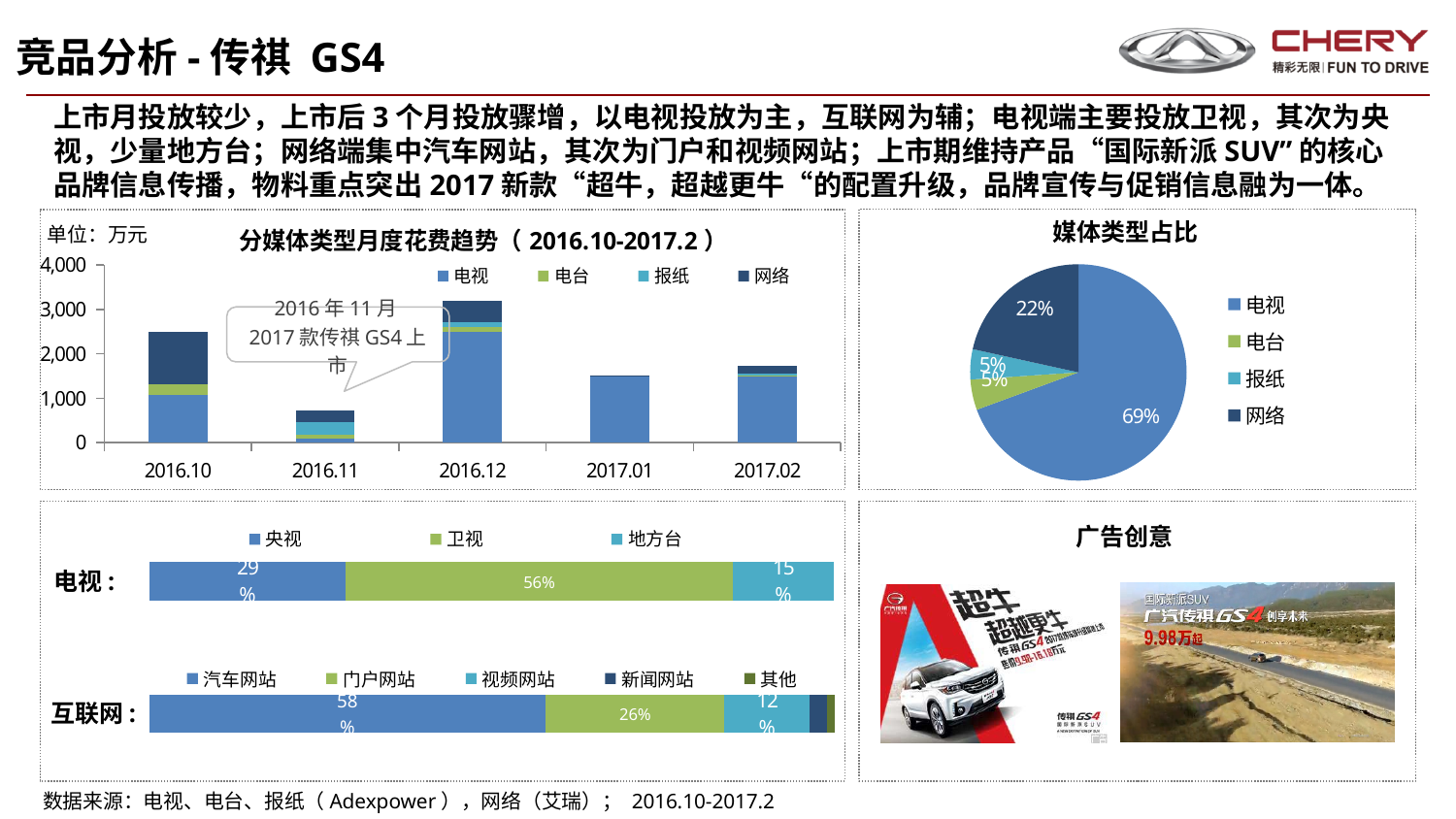
In the 互联网 stacked bar, how many series does the legend list? 5 In the 分媒体类型月度花费趋势 chart, is the total for 2016.11 greater or less than 1,000? less In the 媒体类型占比 pie chart, how many slices are there? 4 In the 电视 stacked bar, what is the value for 卫视? 56% In the 媒体类型占比 pie chart, which media type has the largest slice? 电视 In the 媒体类型占比 pie chart, what share does 网络 have? 22% In the 电视 stacked bar, what is the difference between 卫视 and 地方台? 41% In the 分媒体类型月度花费趋势 chart, what kind of chart is it? stacked bar chart In the 分媒体类型月度花费趋势 chart, which month has the highest total spend? 2016.12 In the 互联网 stacked bar, what is the value for 汽车网站? 58% In the 媒体类型占比 pie chart, what share does 电视 have? 69% In the 电视 stacked bar, what is the value for 央视? 29%